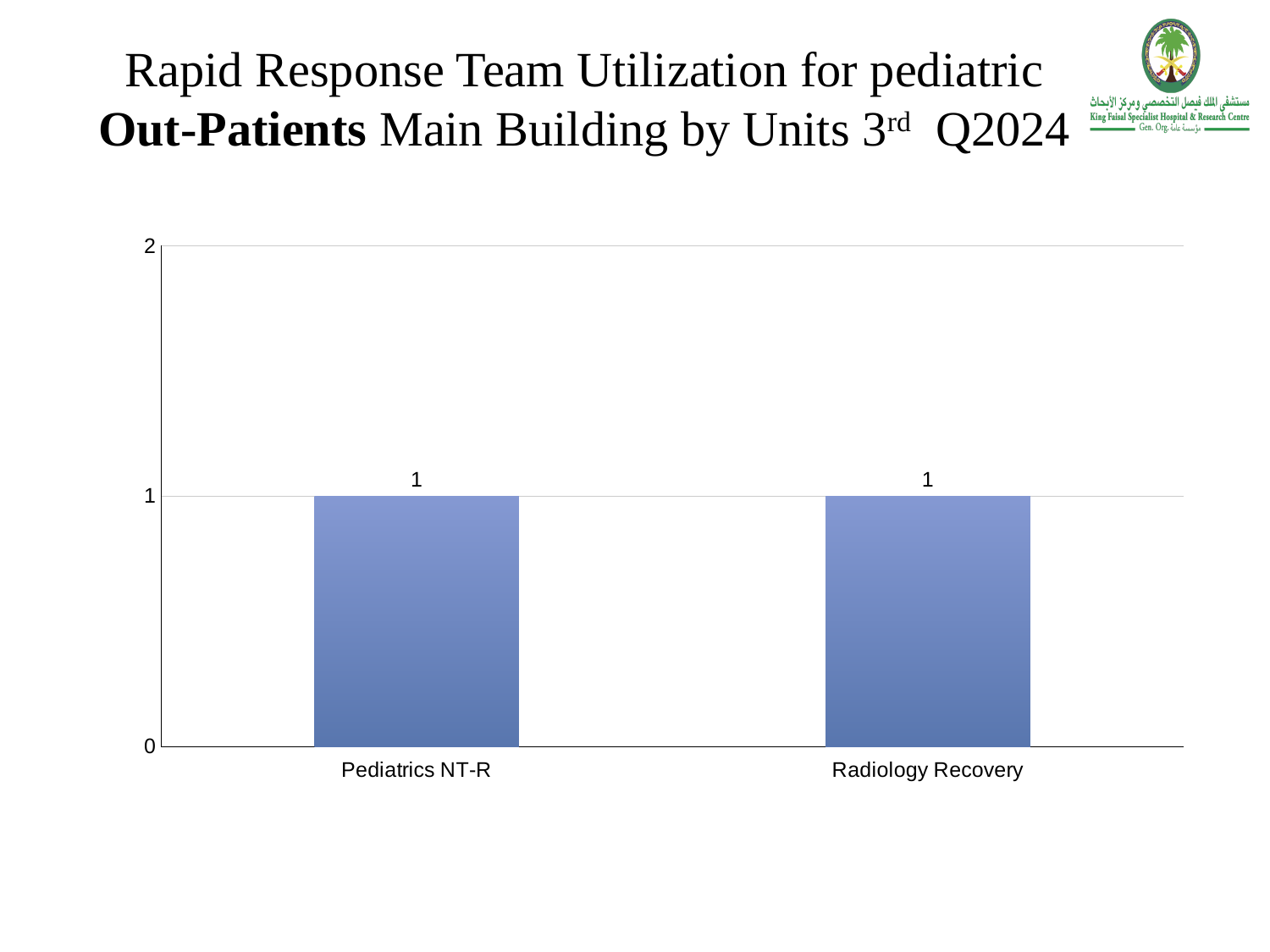
What is the total of the values for Pediatrics NT-R and Radiology Recovery? 2 What kind of chart is shown on the slide? bar chart What is the highest value shown on the y axis? 2 Is the value for Radiology Recovery greater or less than 2? less What is the value for Radiology Recovery? 1 How many categories are shown on the x axis? 2 What is the difference between the values for Pediatrics NT-R and Radiology Recovery? 0 Which quarter does the slide title say the chart covers? 3rd Q2024 Is the value for Pediatrics NT-R greater or less than 2? less What is the value for Pediatrics NT-R? 1